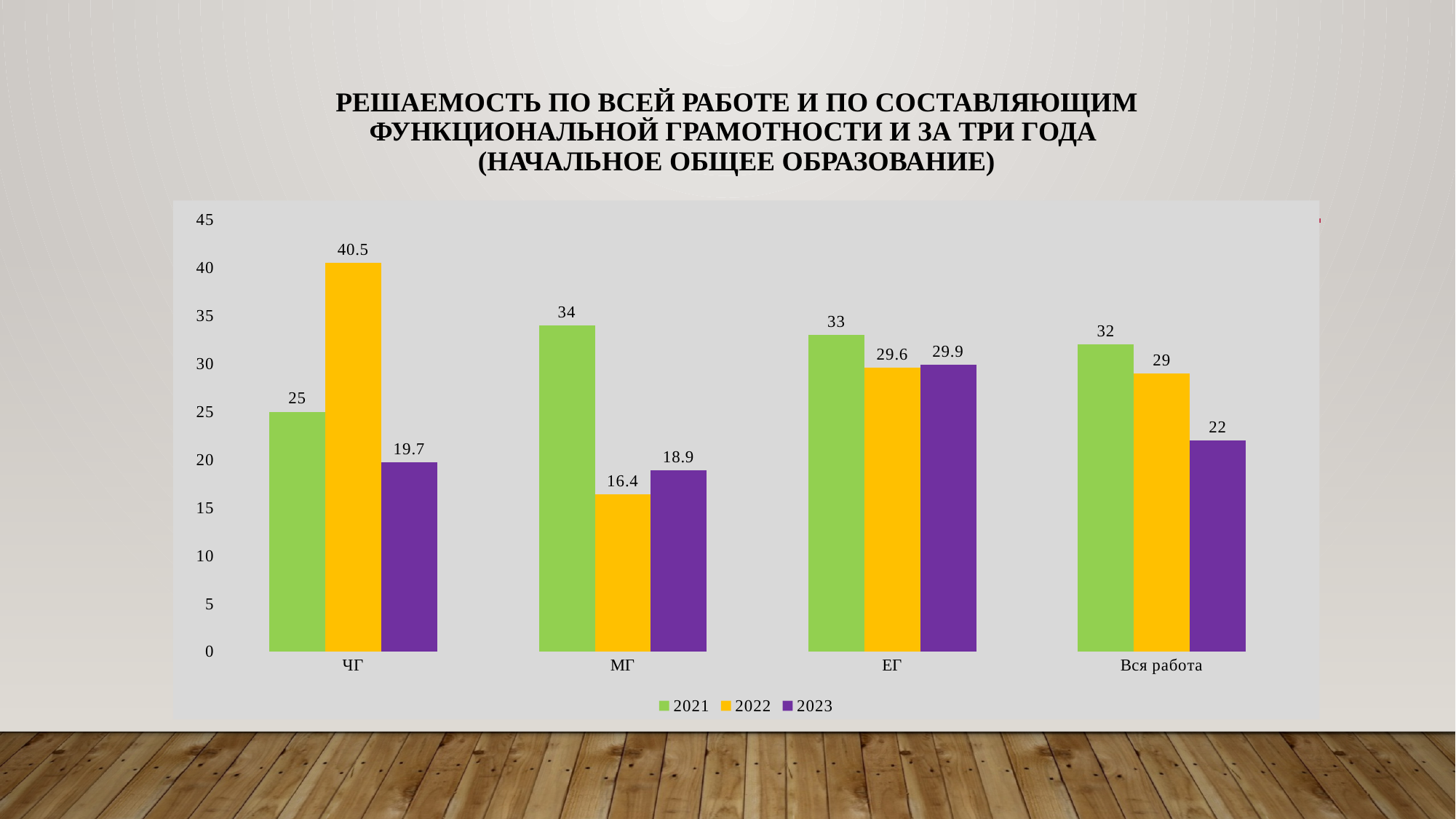
What is the difference between the 2022 and 2021 values in the ЧГ category? 15.5 Which colour represents the 2023 series in the legend? purple Which category has the lowest value for the 2023 series? МГ Which is larger in the ЕГ category: the 2021 value or the 2022 value? 2021 What is the difference between the 2021 and 2023 values in the Вся работа category? 10 What is the value for 2023 in the МГ category? 18.9 How many categories are shown on the x axis? 4 What is the value for 2021 in the Вся работа category? 32 How many series does the legend list? 3 What is the value for 2022 in the ЧГ category? 40.5 Which category has the highest value for the 2022 series? ЧГ What kind of chart is shown on the slide? bar chart